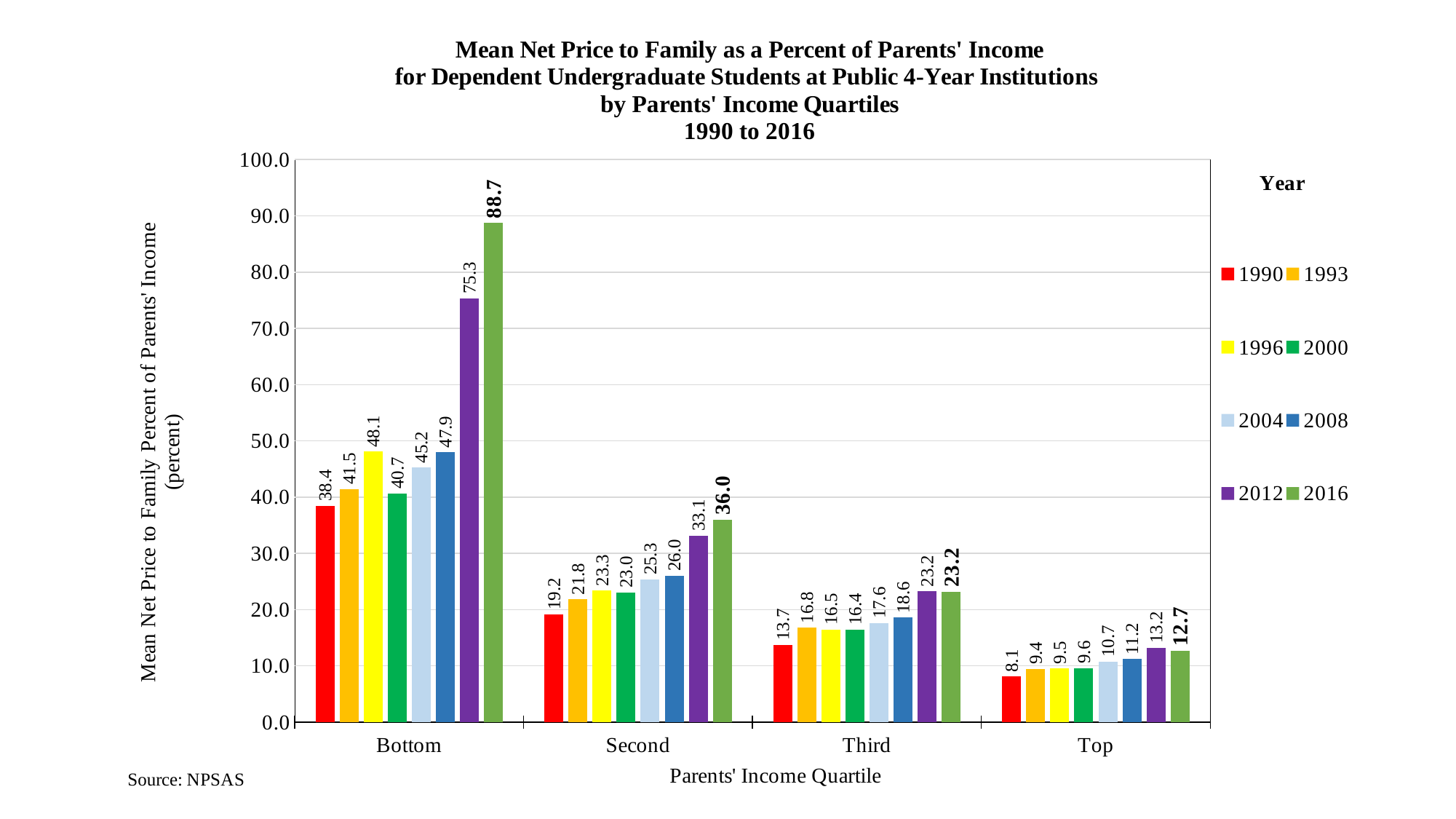
Which income quartile has the lowest value in 1990? Top How many years does the legend list? 8 What is the value for the Bottom quartile in 2016? 88.7 Is the value for the Bottom quartile in 2012 greater or less than 70.0? greater What is the value for the Third quartile in 2004? 17.6 What kind of chart is shown on the slide? Bar chart What is the difference between the 2016 and 2012 values for the Bottom quartile? 13.4 How many income quartile categories are shown on the x axis? 4 What is the value for the Second quartile in 2008? 26.0 Which is larger for the Bottom quartile: the 1996 value or the 2000 value? 1996 What is the value for the Top quartile in 1990? 8.1 Which income quartile has the highest value in 2016? Bottom